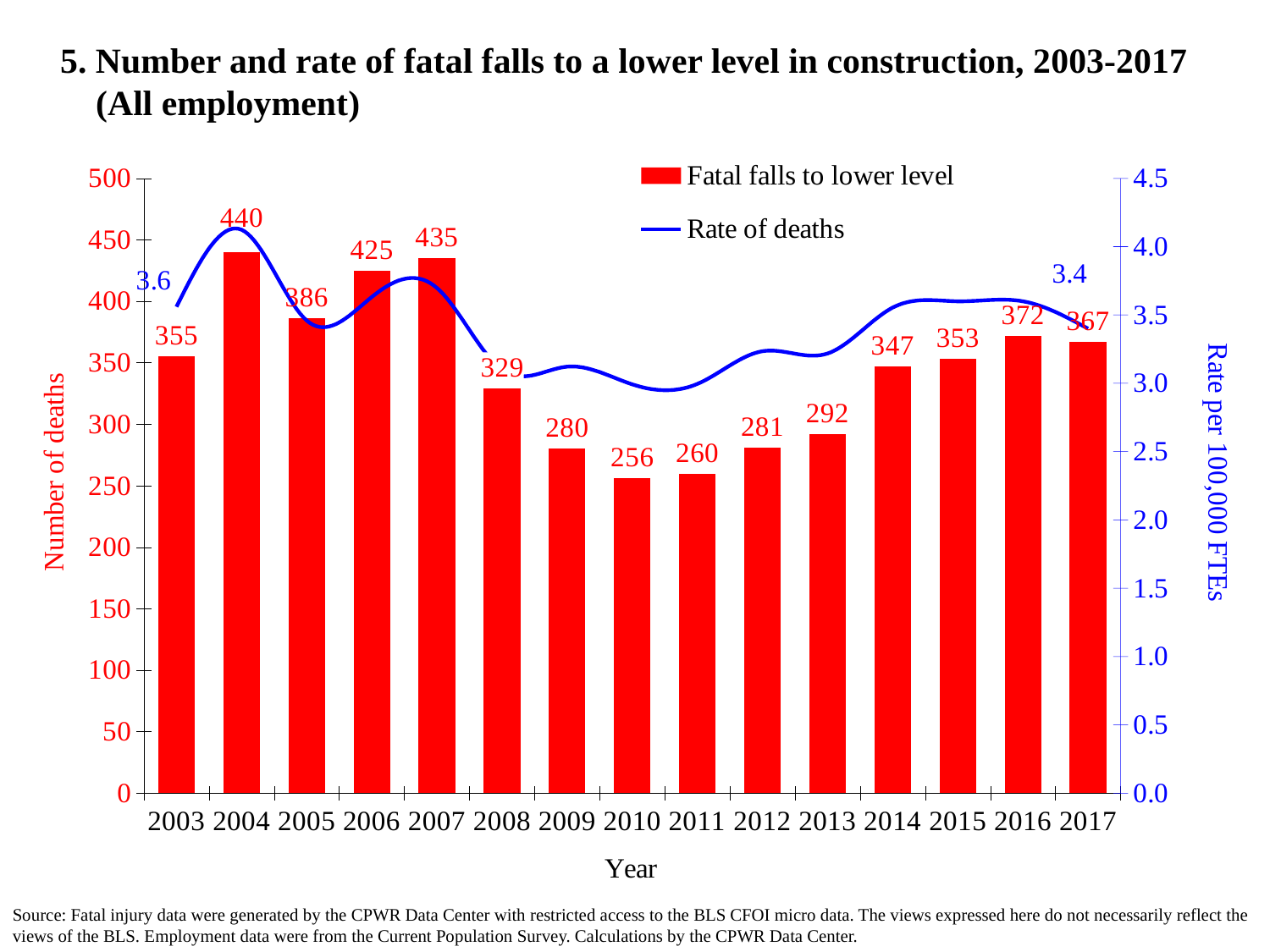
What is the difference in the number of fatal falls to a lower level between 2004 and 2010? 184 How many years are shown on the x axis of the chart? 15 Did the number of fatal falls to a lower level rise or fall from 2013 to 2016? rise Which year had the lowest number of fatal falls to a lower level? 2010 How many series does the legend list? 2 Which year had more fatal falls to a lower level, 2007 or 2006? 2007 How many fatal falls to a lower level were there in 2004? 440 What is the label of the right-hand vertical axis? Rate per 100,000 FTEs What was the rate of deaths per 100,000 FTEs in 2017? 3.4 Which year had the highest number of fatal falls to a lower level? 2004 What was the number of fatal falls to a lower level in 2010? 256